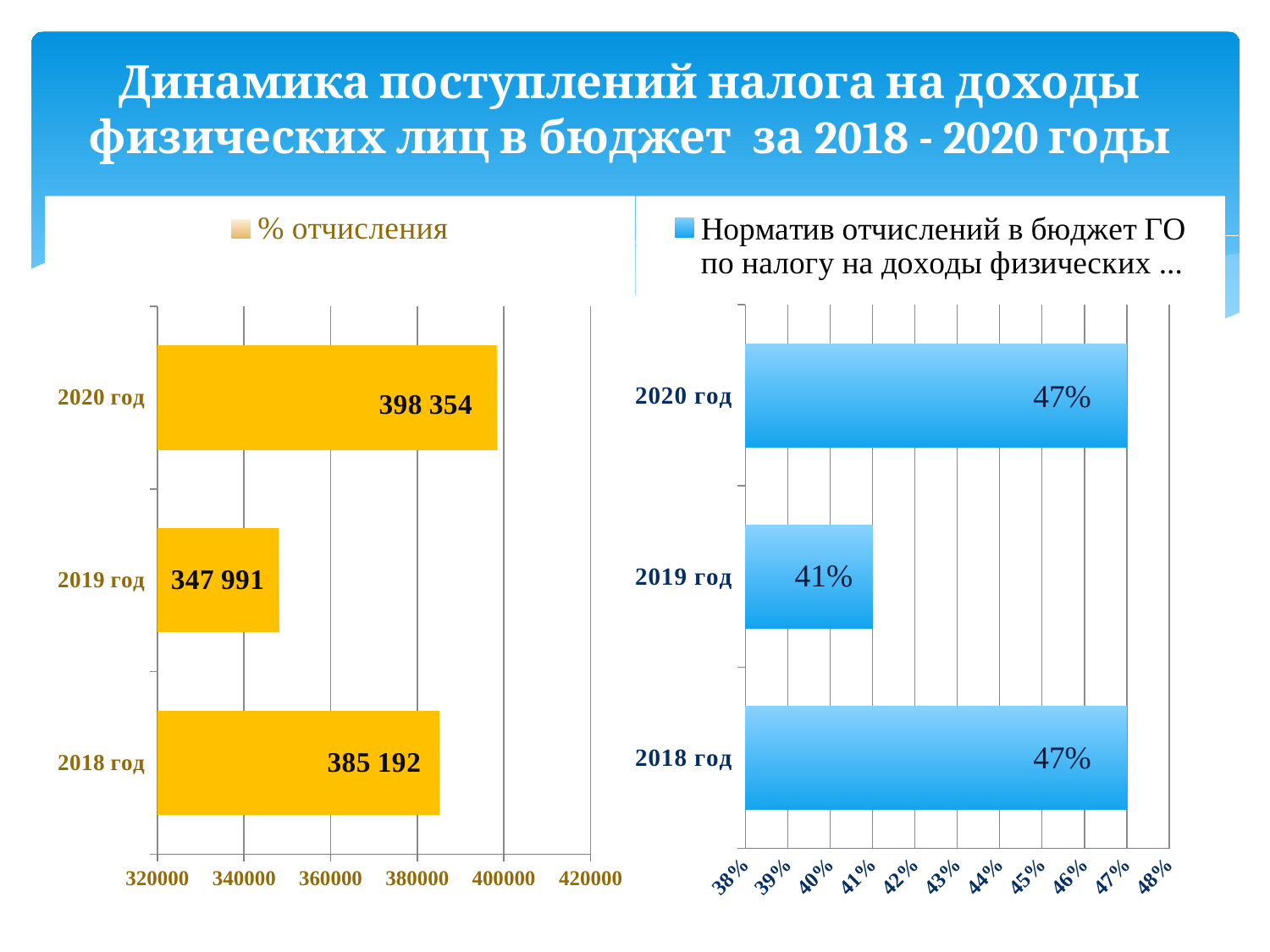
In the right chart, what is the value for 2020 год? 47% In the right chart, which year has the lowest value? 2019 год In the right chart, what is the value for 2019 год? 41% In the left chart, what is the value for 2019 год? 347 991 In the left chart, which year has the lowest value? 2019 год In the left chart, what is the difference between the values for 2020 год and 2018 год? 13 162 In the left chart, what is the value for 2020 год? 398 354 In the left chart, what is the value for 2018 год? 385 192 What type of chart is the left chart? Bar chart In the left chart, which year has the highest value? 2020 год In the left chart, is the value for 2018 год greater or less than 380000? greater In the right chart, what is the difference between the values for 2020 год and 2019 год? 6%